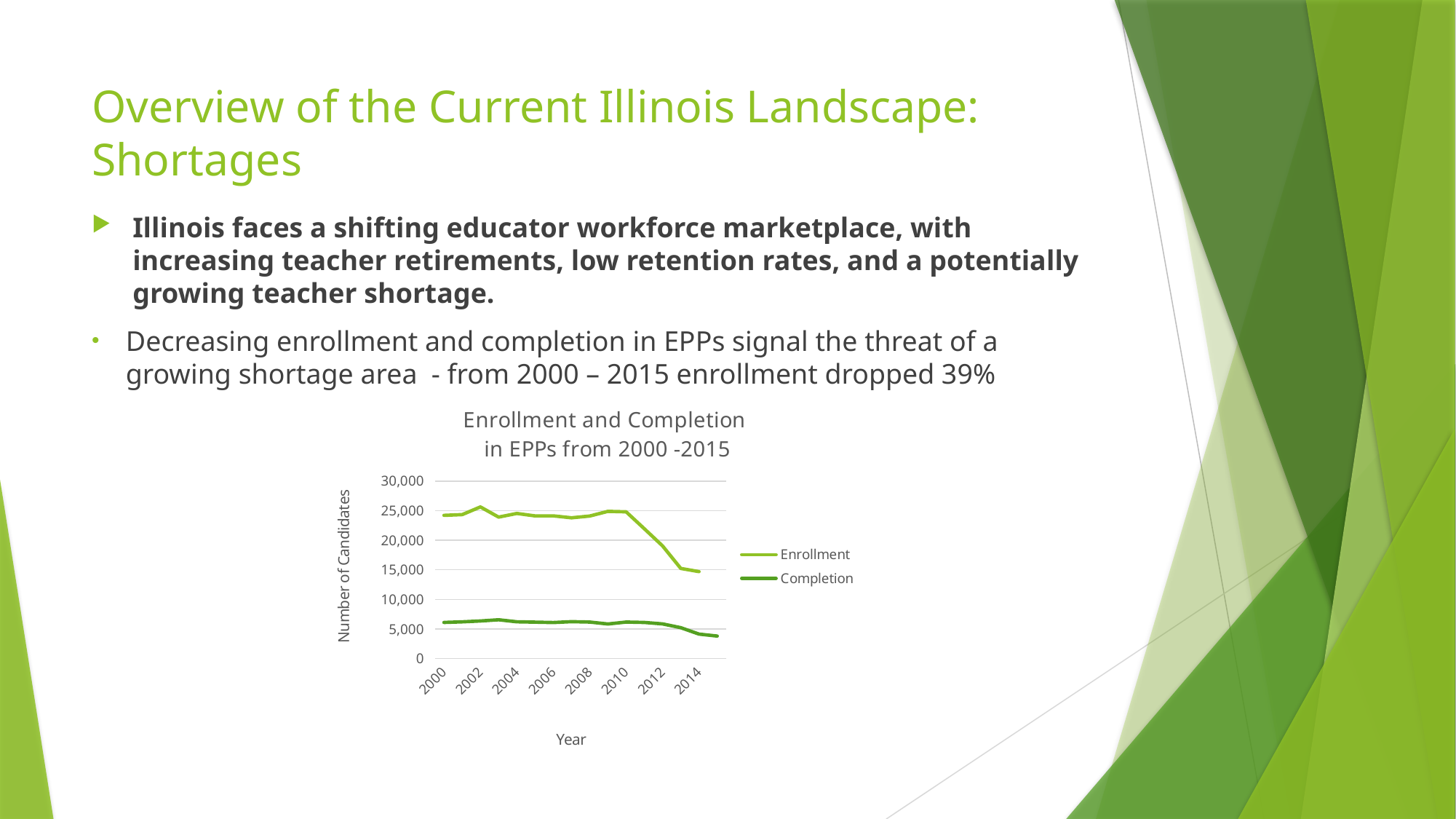
Is the Enrollment value for 2000 greater or less than 20,000? greater What is the title of the chart? Enrollment and Completion in EPPs from 2000 -2015 What kind of chart is shown on the slide? Line chart How many series does the chart's legend list? 2 Does the Enrollment line rise or fall overall from 2000 to the end of the series? Fall Is the Completion value for 2014 greater or less than 5,000? less Does the Completion line rise or fall between 2012 and 2014? Fall Is the Enrollment value for 2014 greater or less than 20,000? less How many year labels are shown on the x axis? 8 In 2010, which series has the larger value, Enrollment or Completion? Enrollment What are the two series named in the chart's legend? Enrollment and Completion